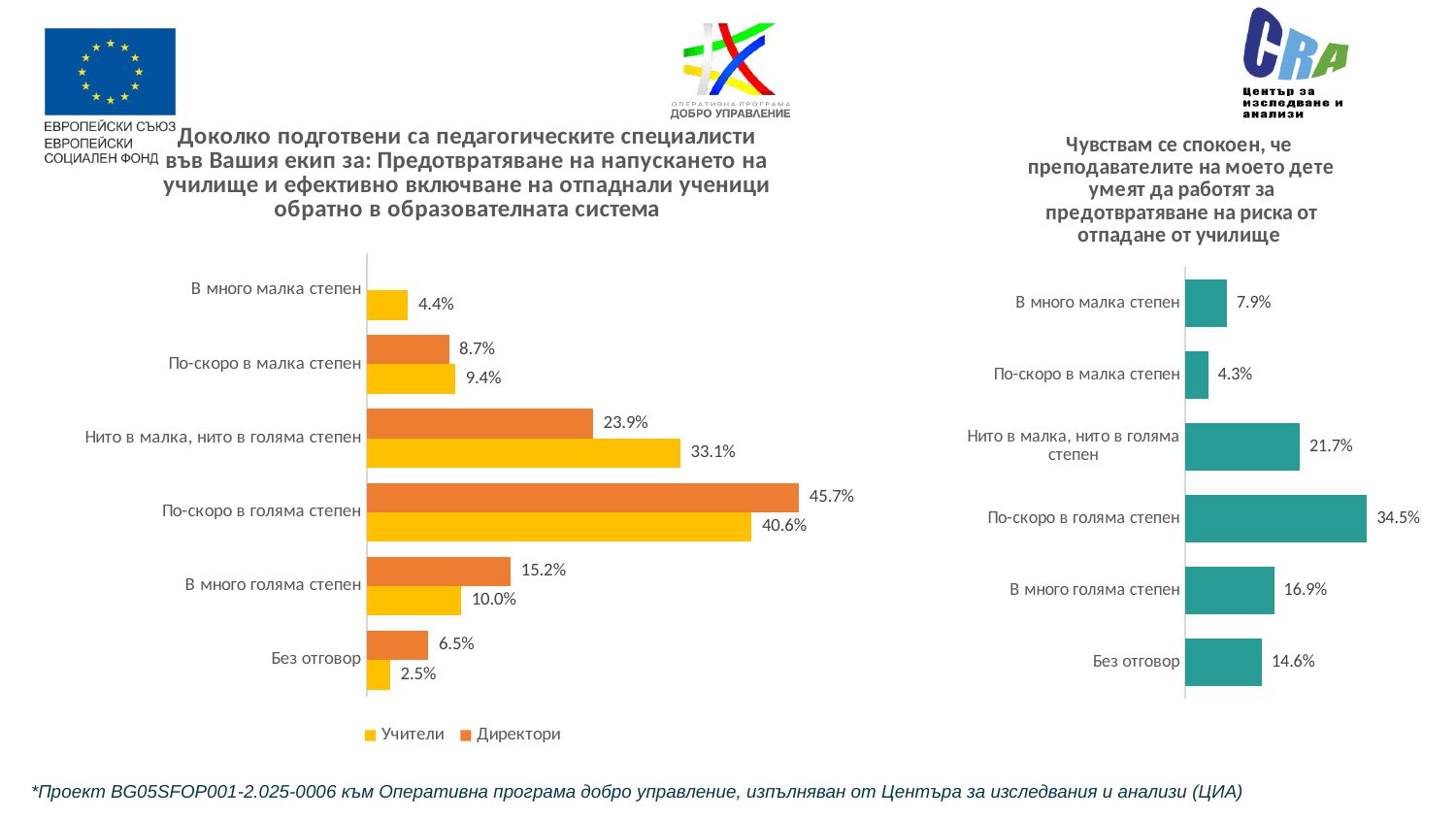
In the right chart, what is the value for 'По-скоро в голяма степен'? 34.5% What type of chart is the left chart? Bar chart In the right chart, what is the difference between 'Нито в малка, нито в голяма степен' and 'В много голяма степен'? 4.8% In the left chart, which category has the highest value for Учители? По-скоро в голяма степен How many series does the legend of the left chart list? 2 In the left chart, what is the value for Учители for 'Нито в малка, нито в голяма степен'? 33.1% In the left chart, what is the value for Директори for 'По-скоро в голяма степен'? 45.7% How many categories are shown in the right chart? 6 In the left chart, for 'Без отговор', which series has the larger value, Учители or Директори? Директори In the right chart, which category has the lowest value? По-скоро в малка степен In the left chart, which category has the lowest value for Учители? Без отговор In the left chart, what is the difference between Директори and Учители for 'В много голяма степен'? 5.2%